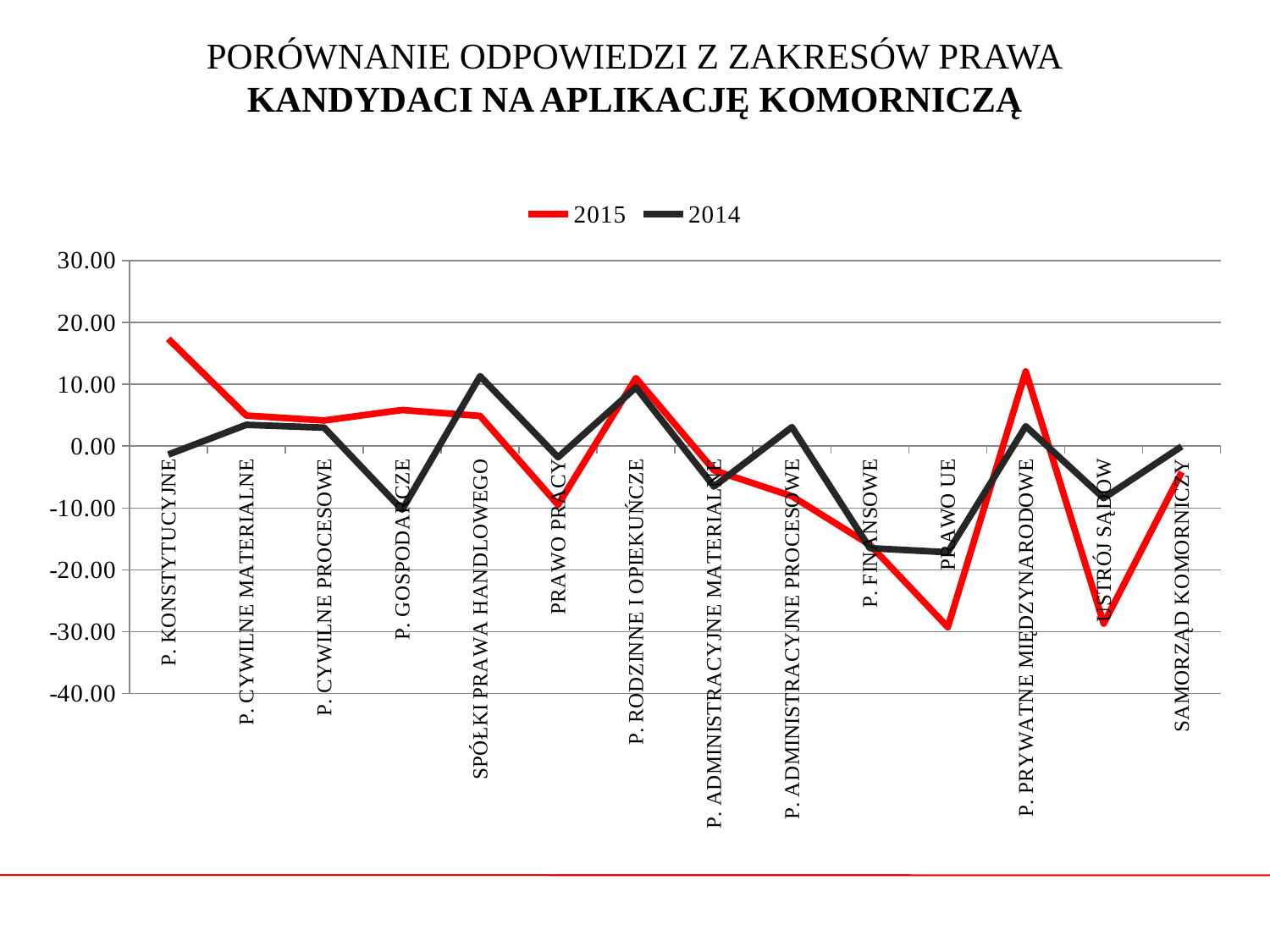
How many categories are plotted along the x axis? 14 Is the 2015 value for PRAWO UE greater or less than -20.00? less Is the 2015 value for P. FINANSOWE greater or less than -10.00? less Is the 2015 value for P. KONSTYTUCYJNE greater or less than 10.00? greater What kind of chart is shown on the slide? line chart How many series does the legend list? 2 Which category has the highest value for the 2015 series? P. KONSTYTUCYJNE For P. GOSPODARCZE, which series has the larger value, 2015 or 2014? 2015 For USTRÓJ SĄDÓW, which series has the larger value, 2015 or 2014? 2014 Which colour is used for the 2015 series in the legend? red